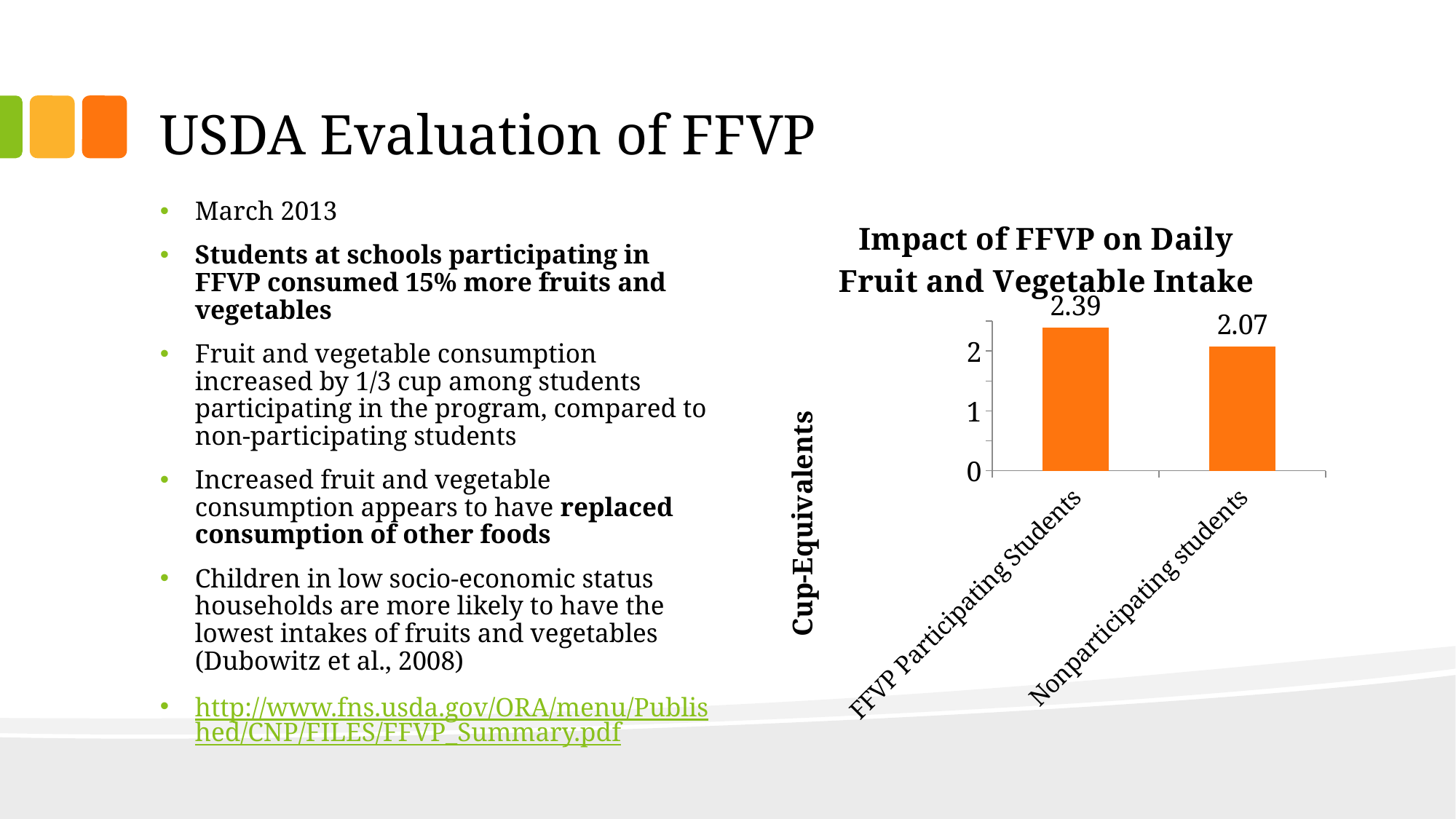
What is the title of the chart? Impact of FFVP on Daily Fruit and Vegetable Intake How many categories are shown in the chart? 2 Is the value for Nonparticipating students greater or less than 2? greater What kind of chart is shown on the slide? bar chart What is the value for FFVP Participating Students? 2.39 Which category has the lowest value? Nonparticipating students What is the label of the vertical axis? Cup-Equivalents What is the difference between the values for FFVP Participating Students and Nonparticipating students? 0.32 What is the value for Nonparticipating students? 2.07 Which is larger, the value for FFVP Participating Students or the value for Nonparticipating students? FFVP Participating Students Which category has the highest value? FFVP Participating Students